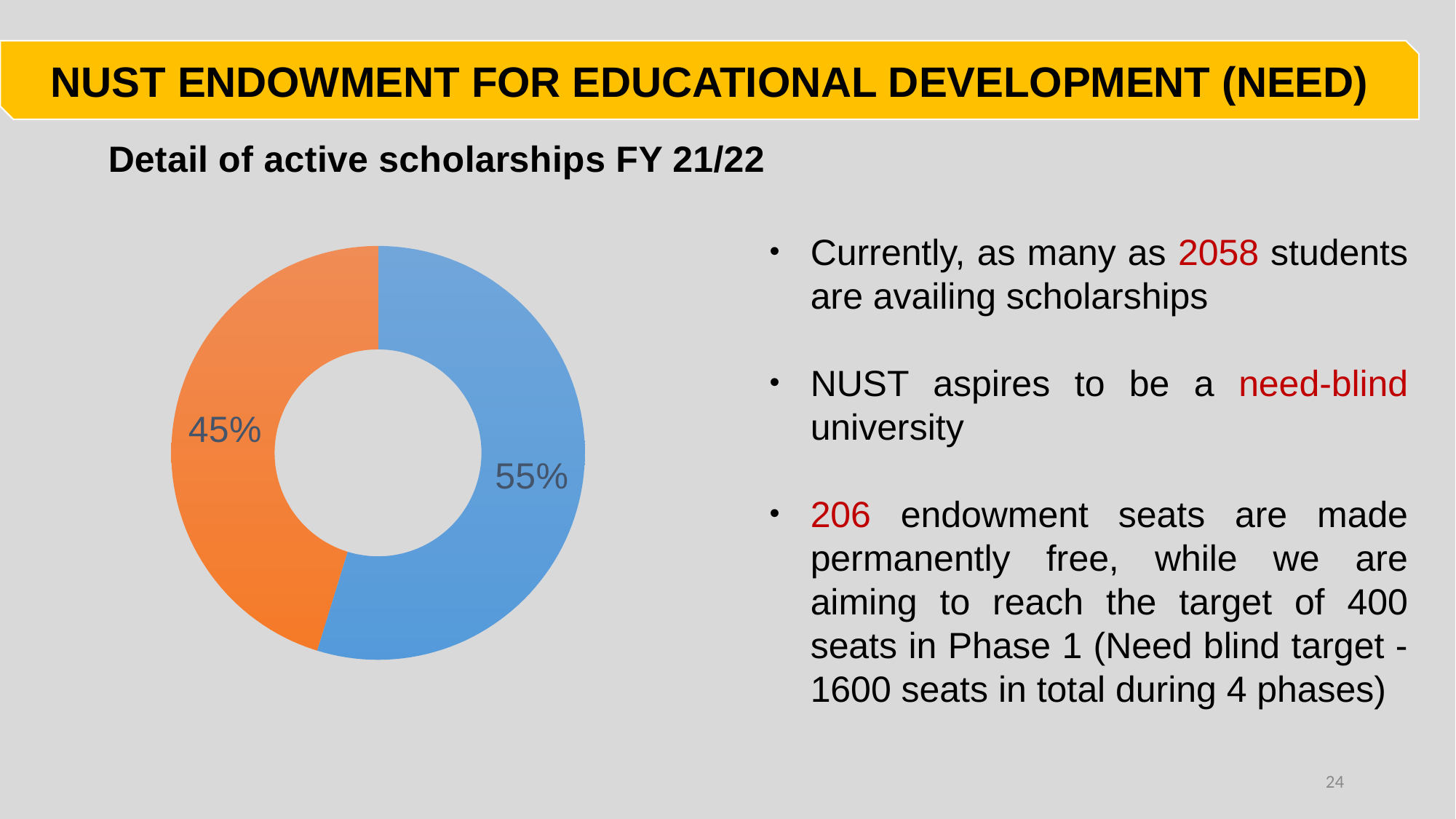
Is the value of the orange slice in the doughnut chart greater or less than 50%? less How many slices does the doughnut chart have? 2 What share of the doughnut chart does the blue slice represent? 55% What two colours are used for the slices of the doughnut chart? blue and orange What percentage is shown on the blue slice of the doughnut chart? 55% Which slice of the doughnut chart is the smallest? the orange slice (45%) What is the difference in percentage points between the blue slice and the orange slice of the doughnut chart? 10 percentage points What is the heading shown above the doughnut chart on the slide? Detail of active scholarships FY 21/22 Which slice of the doughnut chart is the largest? the blue slice (55%) Which is larger in the doughnut chart, the blue slice or the orange slice? the blue slice What percentage is shown on the orange slice of the doughnut chart? 45% What kind of chart is shown on the slide? doughnut chart